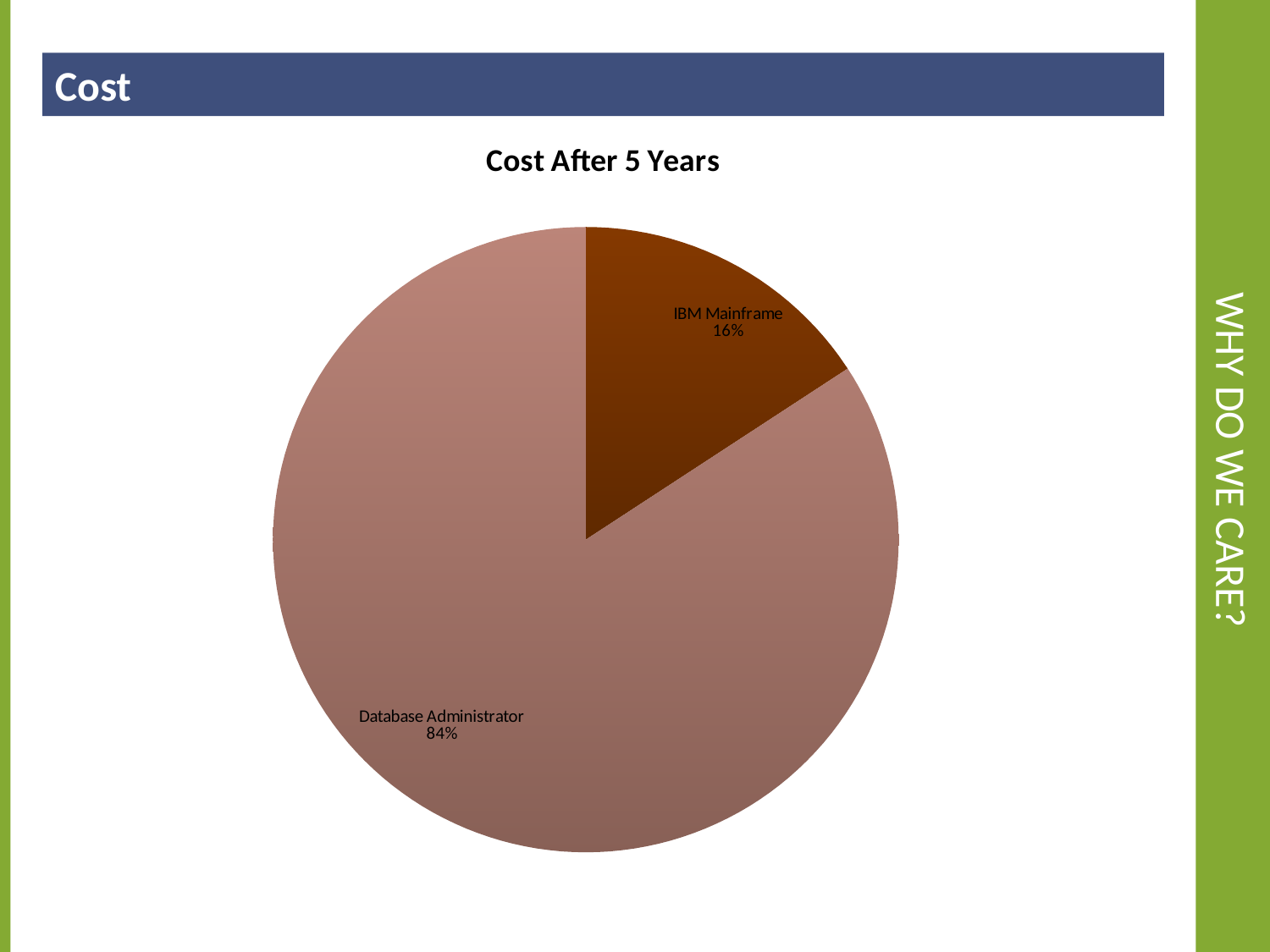
How many slices does the pie chart have? 2 What share of the pie does Database Administrator represent? 84% Which is larger, the IBM Mainframe slice or the Database Administrator slice? Database Administrator Which slice is the smallest? IBM Mainframe What is the value printed on the IBM Mainframe slice? 16% What share of the pie does IBM Mainframe represent? 16% What is the difference in percentage points between the Database Administrator slice and the IBM Mainframe slice? 68 What is the title of the chart? Cost After 5 Years What kind of chart is shown on the slide? pie chart What is the value printed on the Database Administrator slice? 84% Which slice is the largest? Database Administrator